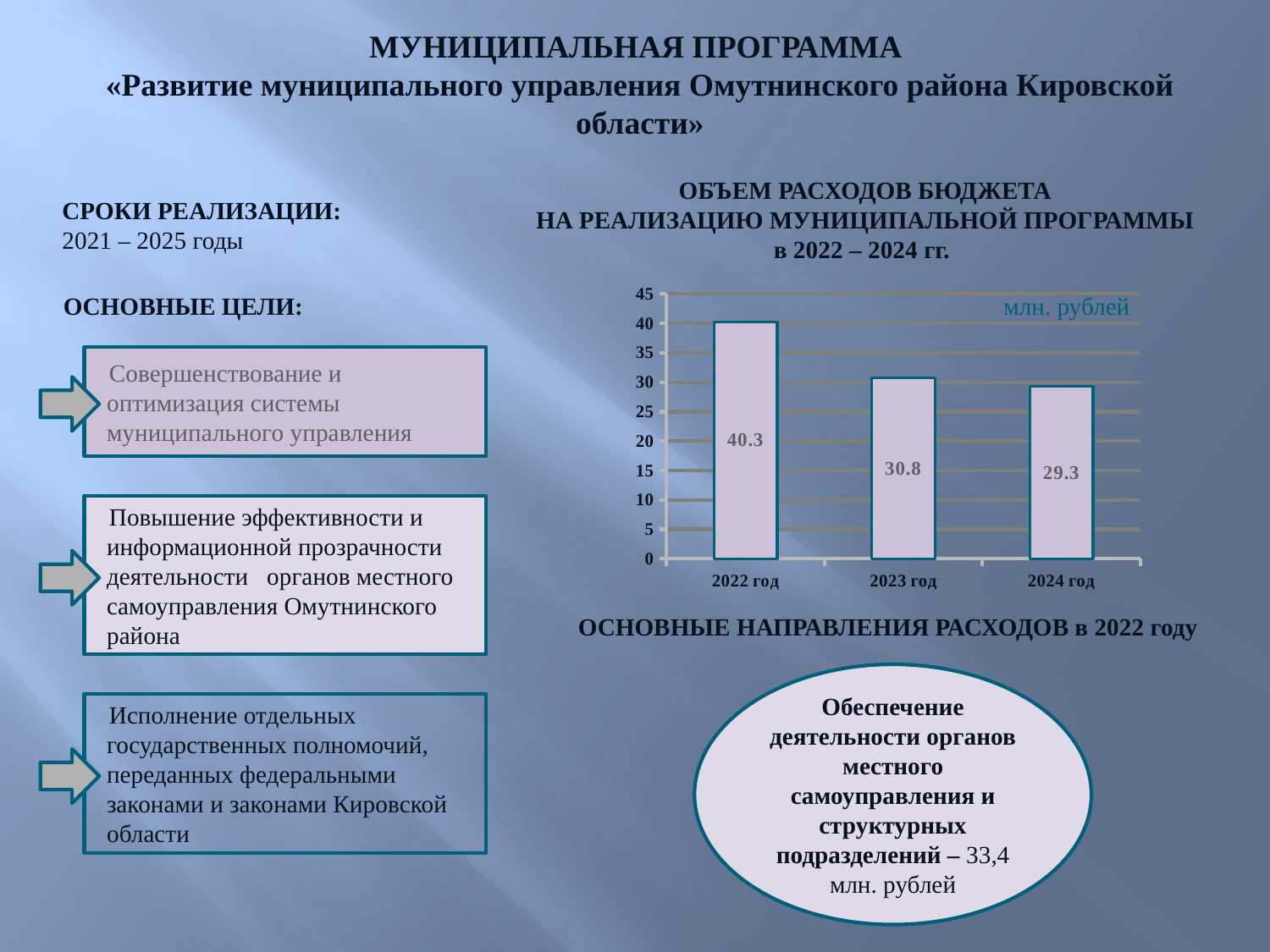
Is the value for 2022 год greater or less than 35? greater Which year has the lowest budget expenditure in the chart? 2024 год Which is larger, the value for 2023 год or the value for 2024 год? 2023 год What is the difference between the values for 2023 год and 2024 год? 1.5 What is the value shown for 2024 год? 29.3 What is the budget expenditure value shown for 2022 год? 40.3 Do the values rise or fall from 2022 год to 2024 год? fall What type of chart is used to show the budget expenditure? bar chart What is the value shown for 2023 год? 30.8 What is the difference between the values for 2022 год and 2023 год? 9.5 Which year has the highest budget expenditure in the chart? 2022 год How many years (categories) are shown in the chart? 3